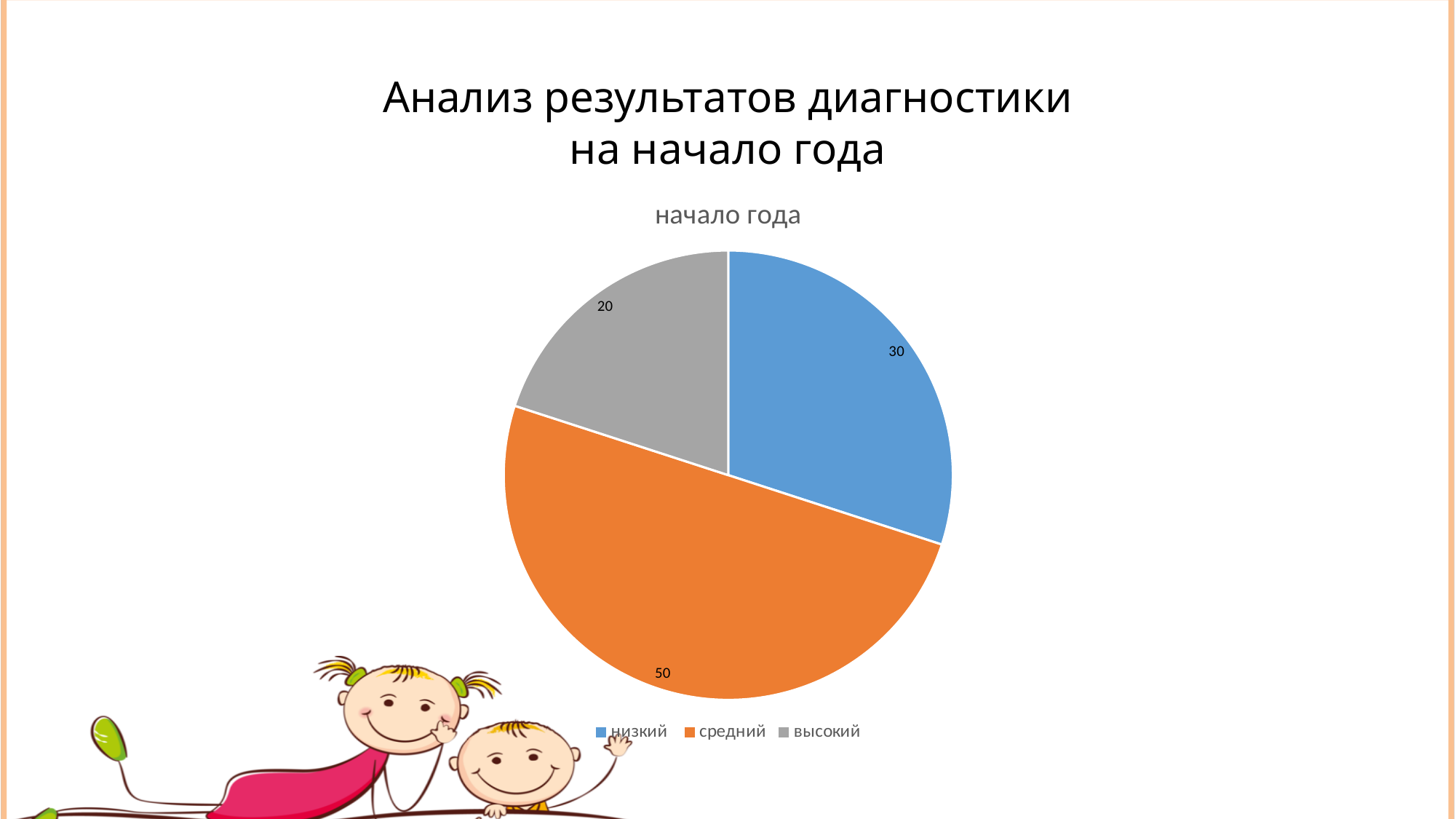
Which category has the largest slice? средний What is the value for низкий? 30 What is the title of the chart? начало года What is the difference between the values for низкий and высокий? 10 What share of the pie does the средний slice represent? 50% What kind of chart is shown on the slide? pie chart What is the value for средний? 50 What is the value for высокий? 20 Which is larger, the value for низкий or the value for высокий? низкий Which category has the smallest slice? высокий How many slices does the pie chart have? 3 What is the difference between the values for средний and низкий? 20